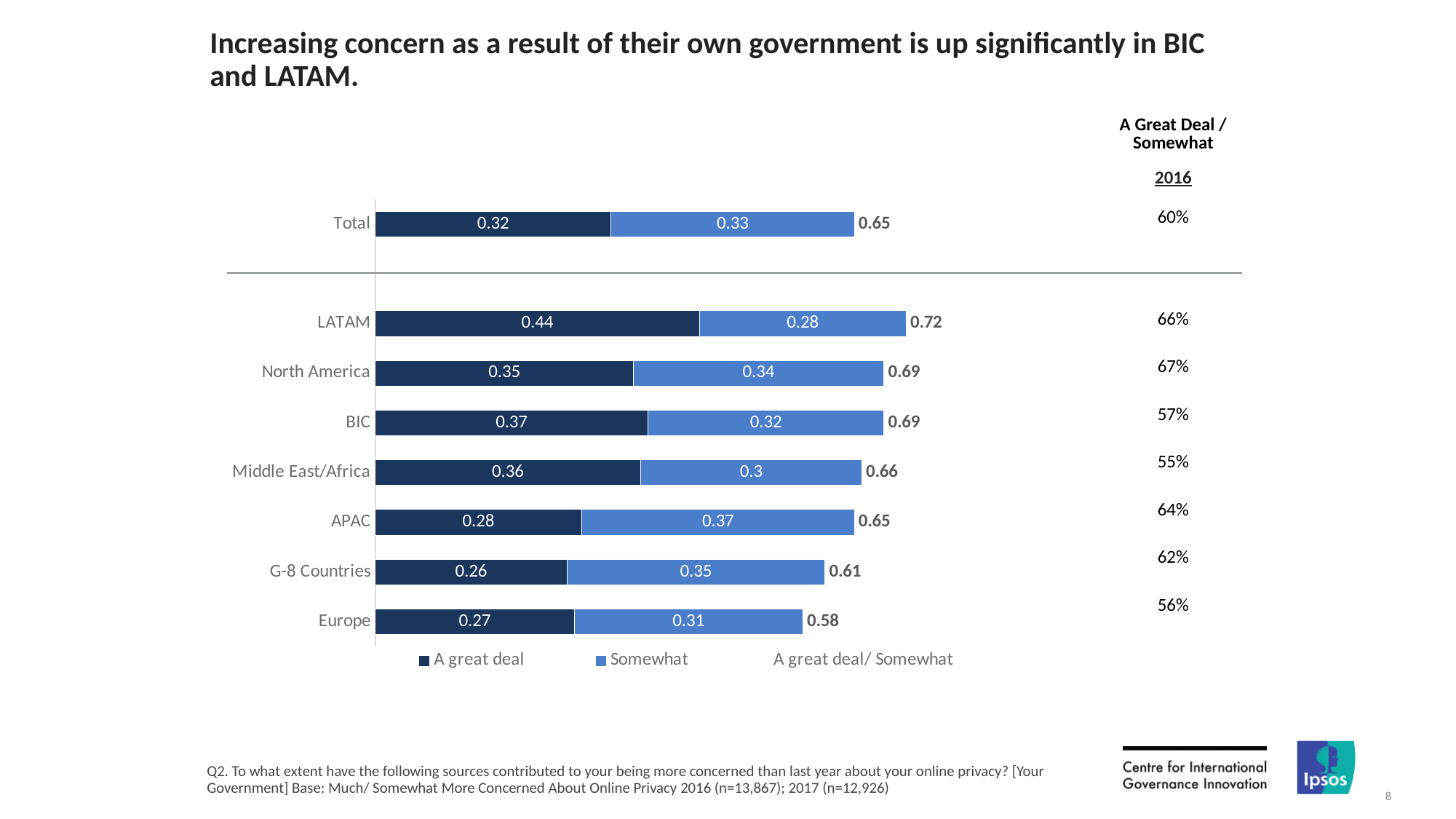
How many entries does the legend list? 3 Which is larger, the 'Somewhat' value for North America or the 'Somewhat' value for Middle East/Africa? North America What is the 2016 'A Great Deal / Somewhat' percentage shown for North America? 67% What is the 'A great deal' value for LATAM? 0.44 What is the combined 'A great deal/ Somewhat' value shown for Europe? 0.58 What is the 'Somewhat' value for APAC? 0.37 Which category has the lowest combined 'A great deal/ Somewhat' value? Europe What is the difference between the 'A great deal' values for LATAM and G-8 Countries? 0.18 What kind of chart is shown on the slide? Stacked bar chart How many categories are plotted in the chart, including Total? 8 Which category has the highest 'A great deal' value? LATAM What is the total of the stacked bar for BIC? 0.69